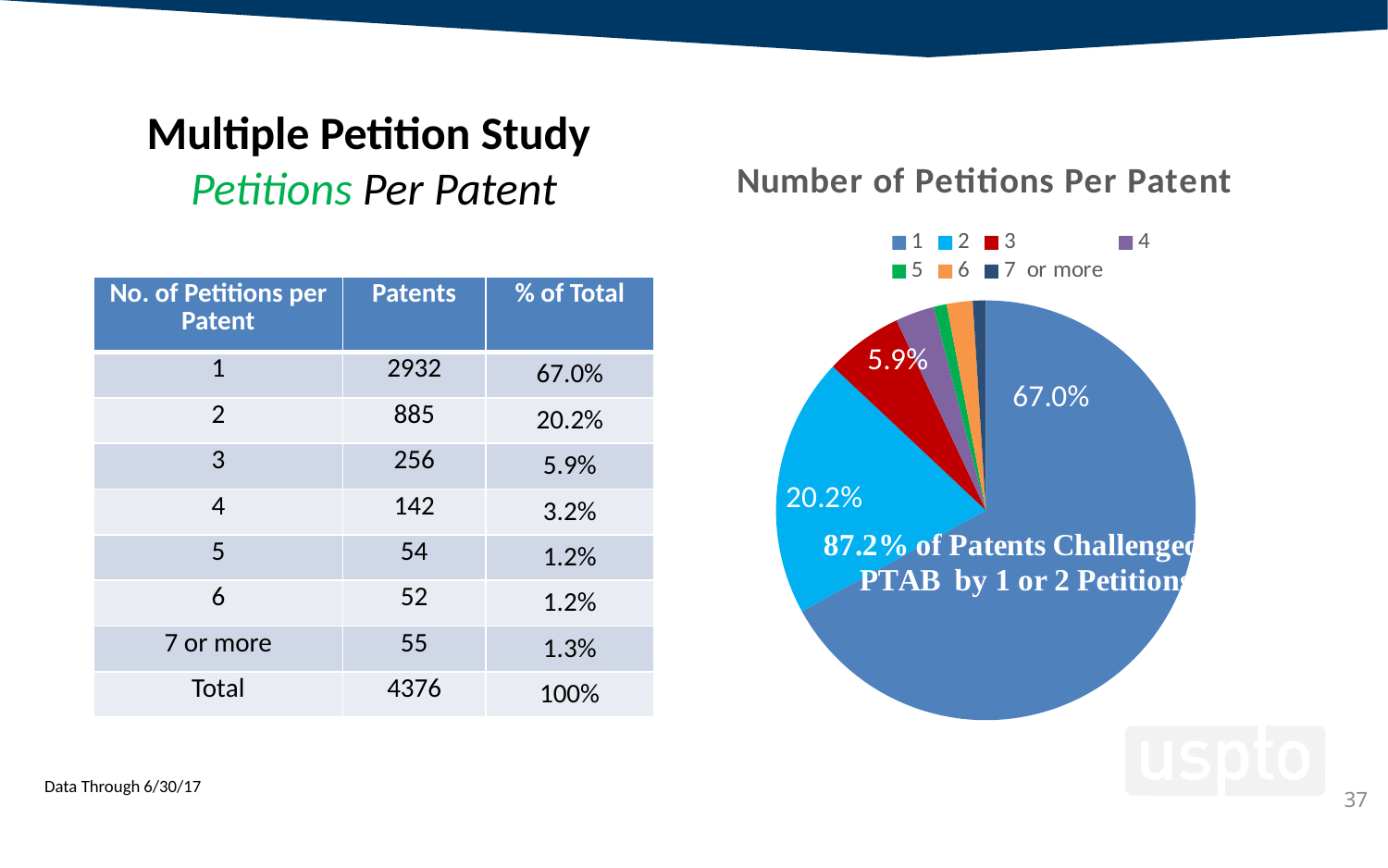
What is the last category listed in the chart's legend? 7 or more What share of the pie does the category '2' represent? 20.2% What is the title of the chart? Number of Petitions Per Patent Which slice is larger, the one for '2' or the one for '3'? 2 What is the difference in percentage points between the slice for '1' and the slice for '2'? 46.8% What is the combined share of the slices for '1' and '2'? 87.2% How many categories does the chart's legend list? 7 Which category has the largest slice of the pie? 1 What share of the pie does the category '1' (one petition per patent) represent? 67.0% What is the difference in percentage points between the slice for '2' and the slice for '3'? 14.3% What share of the pie does the category '3' represent? 5.9% What kind of chart is shown on the slide? pie chart